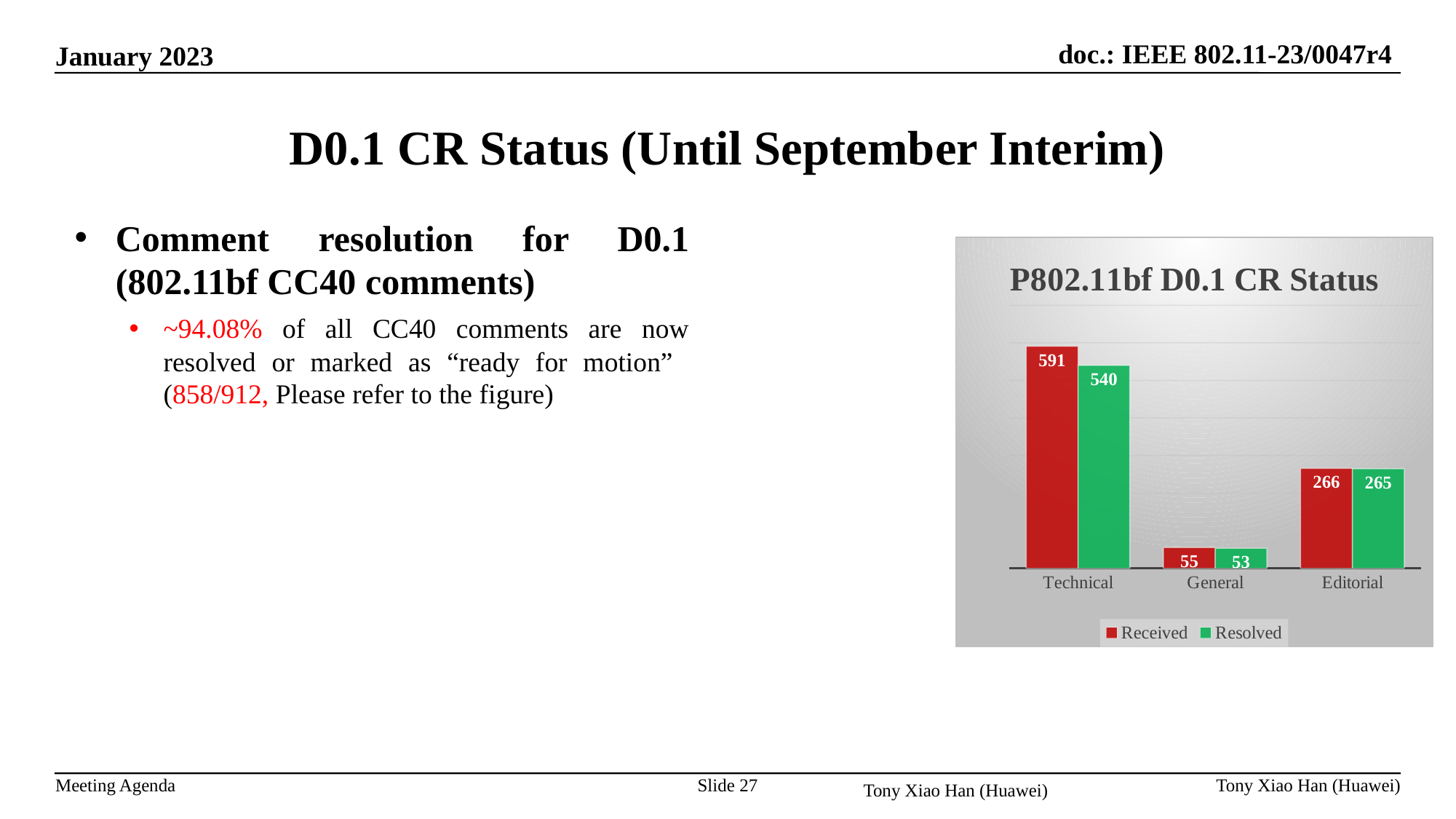
What is the difference between the Received values for Editorial and General? 211 How many categories are shown on the x axis? 3 Which category has the highest Received value? Technical What is the difference between Received and Resolved for Technical? 51 What is the Resolved value for Editorial? 265 Which is larger, the Resolved value for Technical or the Resolved value for Editorial? Technical Which category has the lowest Resolved value? General What is the title of the chart? P802.11bf D0.1 CR Status What is the Resolved value for General? 53 How many series does the legend list? 2 What kind of chart is shown on the slide? Bar chart What is the Received value for Technical? 591